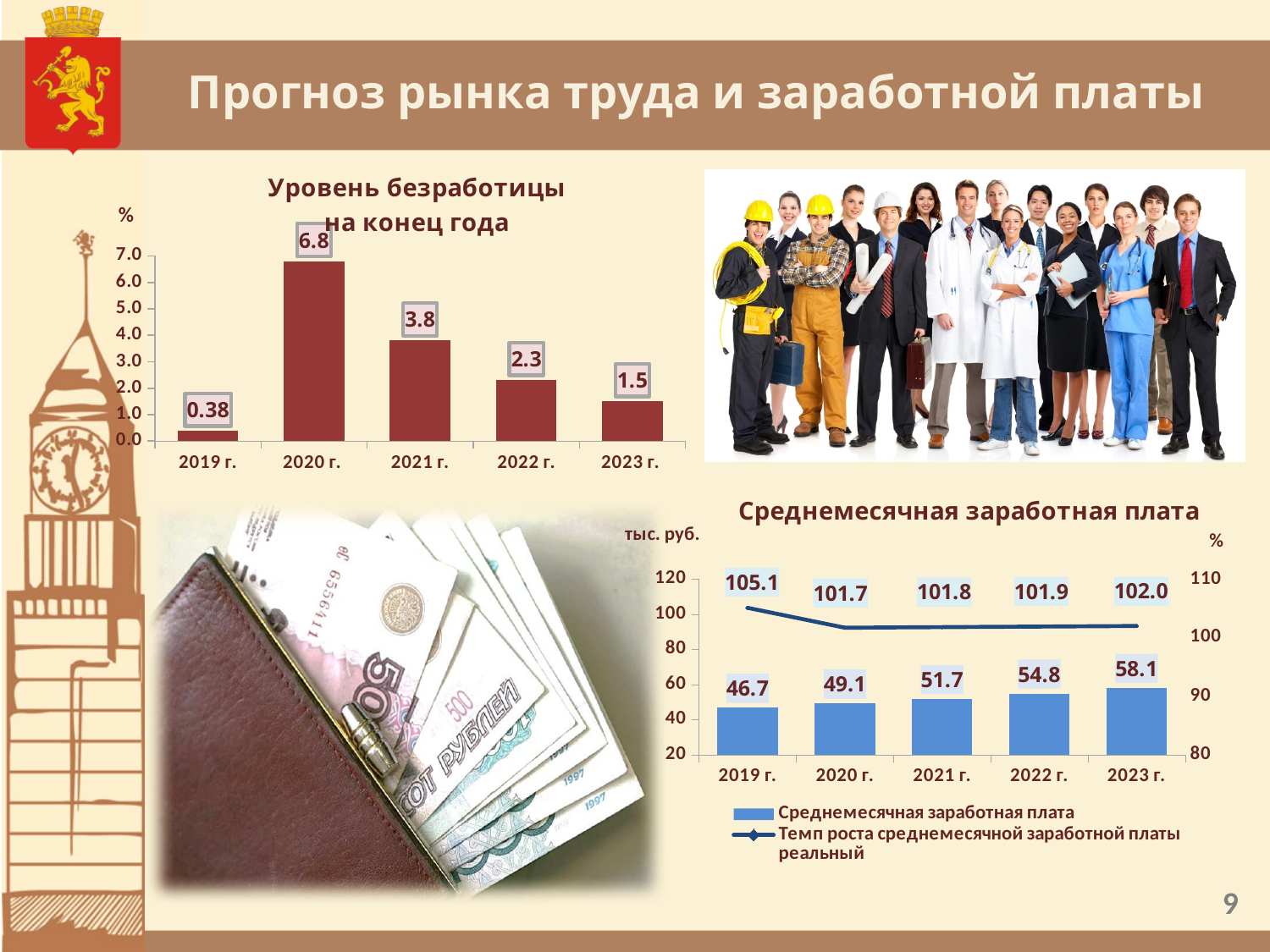
In the chart 'Уровень безработицы на конец года', do the values rise or fall from 2020 г. to 2023 г.? fall In the chart 'Уровень безработицы на конец года', which year has the highest unemployment rate? 2020 г. In the chart 'Среднемесячная заработная плата', how many series does the legend list? 2 In the chart 'Среднемесячная заработная плата', what is the difference between the average monthly salary in 2023 г. and 2019 г.? 11.4 In the chart 'Уровень безработицы на конец года', how many years are shown on the x axis? 5 In the chart 'Уровень безработицы на конец года', what is the unemployment rate for 2020 г.? 6.8 In the chart 'Уровень безработицы на конец года', what is the value for 2019 г.? 0.38 In the chart 'Уровень безработицы на конец года', which year has the lowest unemployment rate? 2019 г. In the chart 'Уровень безработицы на конец года', what is the difference between the values for 2021 г. and 2023 г.? 2.3 In the chart 'Среднемесячная заработная плата', which is larger: the growth rate for 2019 г. or for 2020 г.? 2019 г. In the chart 'Среднемесячная заработная плата', what is the average monthly salary (тыс. руб.) for 2023 г.? 58.1 In the chart 'Среднемесячная заработная плата', what is the real salary growth rate (%) for 2019 г.? 105.1